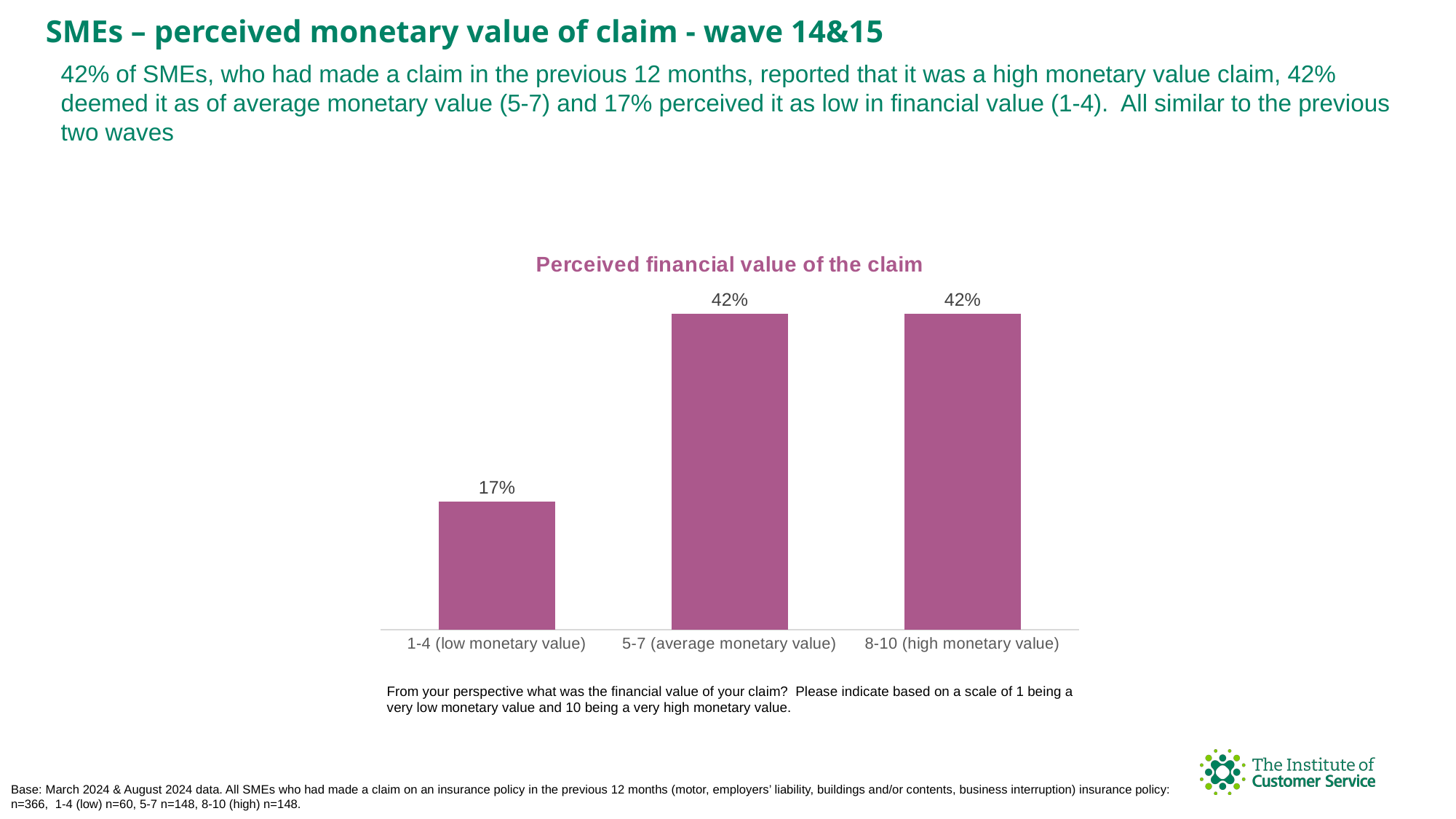
How many categories are shown in the chart? 3 What is the total of the three percentages shown in the chart? 101% Which is larger: the value for 8-10 (high monetary value) or the value for 1-4 (low monetary value)? 8-10 (high monetary value) What is the difference between the value for 5-7 (average monetary value) and the value for 1-4 (low monetary value)? 25% What percentage of SMEs rated their claim as 1-4 (low monetary value)? 17% What percentage of SMEs rated their claim as 5-7 (average monetary value)? 42% What kind of chart is shown on the slide? Bar chart What is the title of the chart? Perceived financial value of the claim What percentage of SMEs rated their claim as 8-10 (high monetary value)? 42% Which category has the lowest value in the chart? 1-4 (low monetary value) Do the values for 5-7 (average monetary value) and 8-10 (high monetary value) differ? No, both are 42%